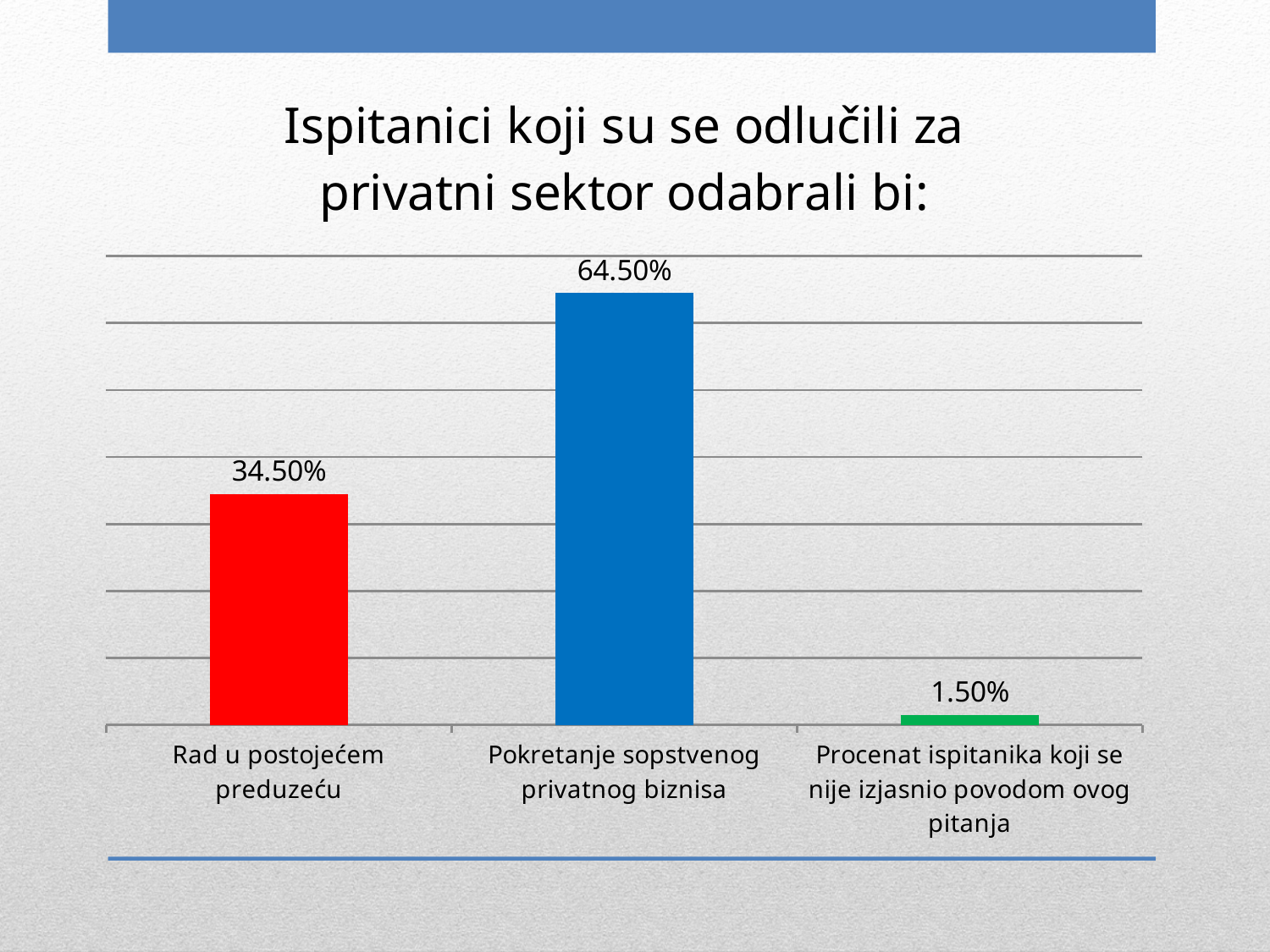
Which category has the lowest value? Procenat ispitanika koji se nije izjasnio povodom ovog pitanja What is the value for "Rad u postojećem preduzeću"? 34.50% What is the title of the slide? Ispitanici koji su se odlučili za privatni sektor odabrali bi: Which is larger: the value for "Rad u postojećem preduzeću" or the value for "Pokretanje sopstvenog privatnog biznisa"? Pokretanje sopstvenog privatnog biznisa What colour is the bar for "Pokretanje sopstvenog privatnog biznisa"? Blue What is the difference between the values for "Rad u postojećem preduzeću" and "Procenat ispitanika koji se nije izjasnio povodom ovog pitanja"? 33.00% How many categories are shown in the chart? 3 What is the value for "Pokretanje sopstvenog privatnog biznisa"? 64.50% What kind of chart is shown on the slide? Bar chart Which category has the highest value? Pokretanje sopstvenog privatnog biznisa What is the difference between the values for "Pokretanje sopstvenog privatnog biznisa" and "Rad u postojećem preduzeću"? 30.00% What is the value for "Procenat ispitanika koji se nije izjasnio povodom ovog pitanja"? 1.50%